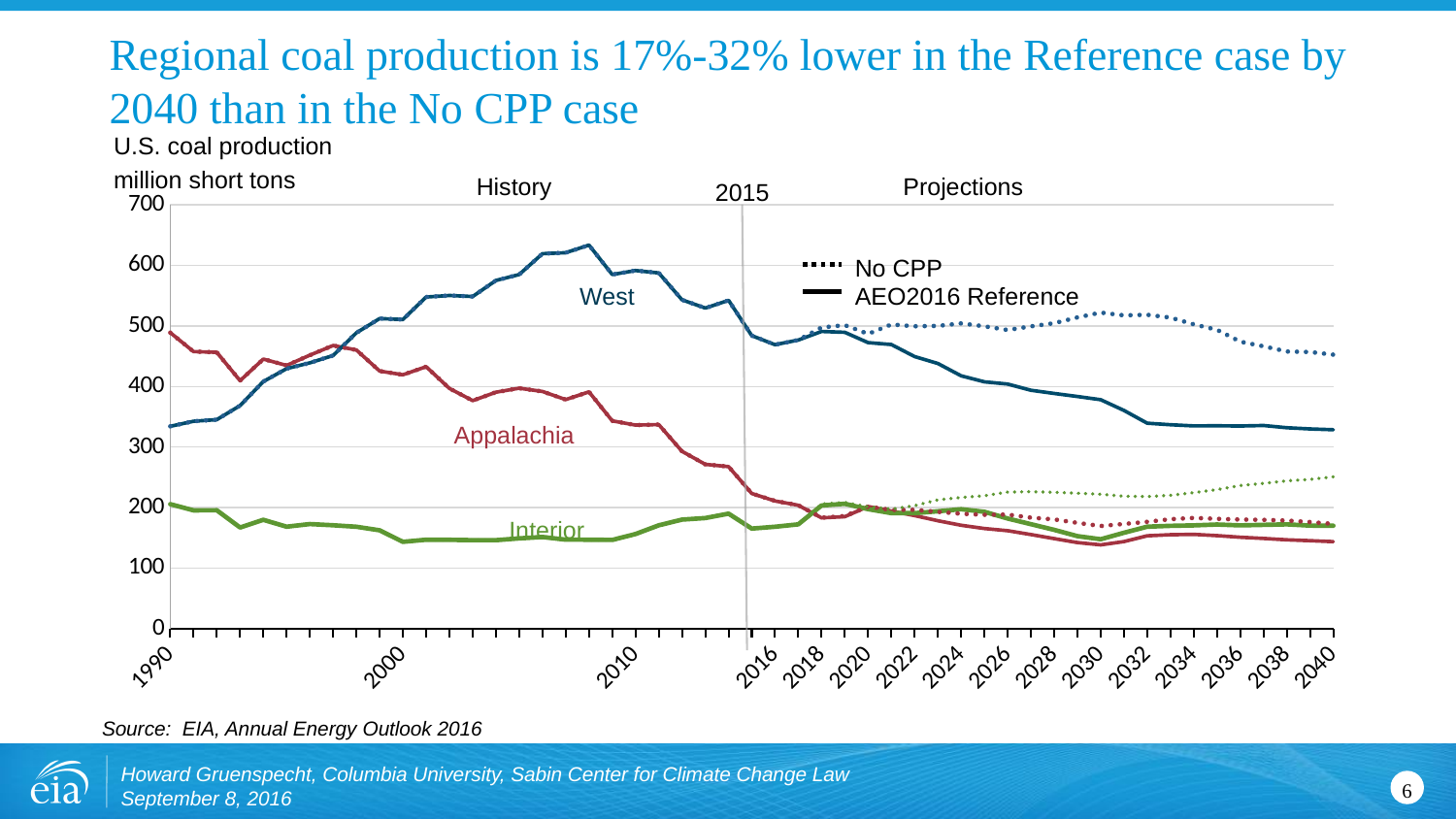
Is the Appalachia value in 1990 greater or less than 400? greater Is the West AEO2016 Reference value in 2040 greater or less than 400? less Which region has the highest coal production in 2015? West What kind of chart is shown on the slide? line chart Which region has the lowest coal production in 1990? Interior In what units is coal production measured on the chart? million short tons In 2000, which region has higher coal production, West or Appalachia? West Does West coal production rise or fall between 1990 and 2008? rise Is the Interior value in 2000 greater or less than 200? less How many entries does the legend list? 2 Does Appalachia coal production rise or fall between 2010 and 2040? fall